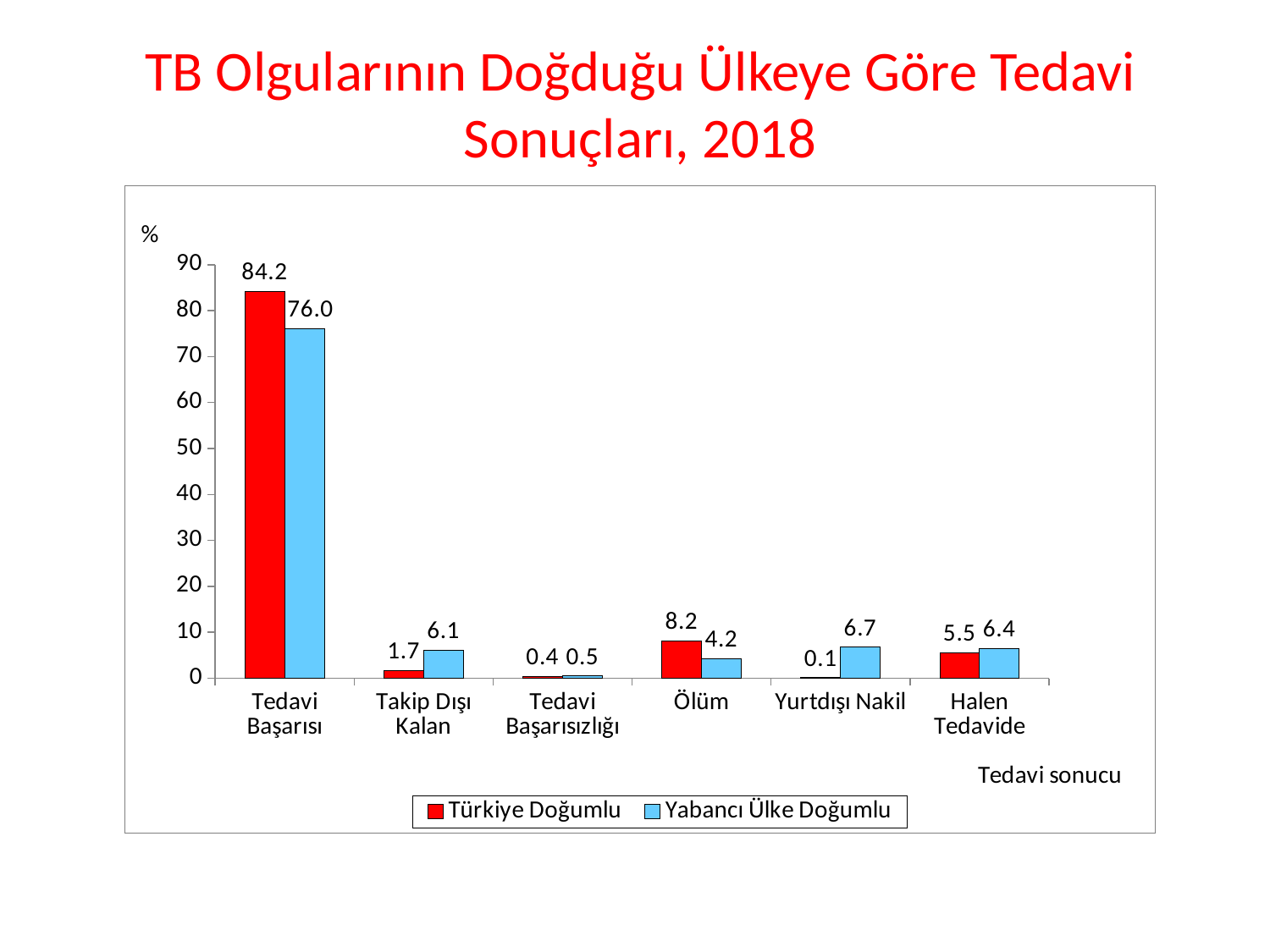
What is the difference between the Türkiye Doğumlu and Yabancı Ülke Doğumlu values in the Tedavi Başarısı category? 8.2 What is the value for Yabancı Ülke Doğumlu in the Ölüm category? 4.2 What is the x axis label of the chart? Tedavi sonucu Is the value for Yabancı Ülke Doğumlu in the Tedavi Başarısı category greater or less than 80? less What is the value for Türkiye Doğumlu in the Tedavi Başarısı category? 84.2 What is the value for Türkiye Doğumlu in the Yurtdışı Nakil category? 0.1 Which category has the lowest value for Türkiye Doğumlu? Yurtdışı Nakil Which is larger in the Takip Dışı Kalan category: Türkiye Doğumlu or Yabancı Ülke Doğumlu? Yabancı Ülke Doğumlu How many categories are shown on the x axis? 6 What kind of chart is shown on the slide? bar chart Which category has the highest value for Yabancı Ülke Doğumlu? Tedavi Başarısı How many series does the legend list? 2